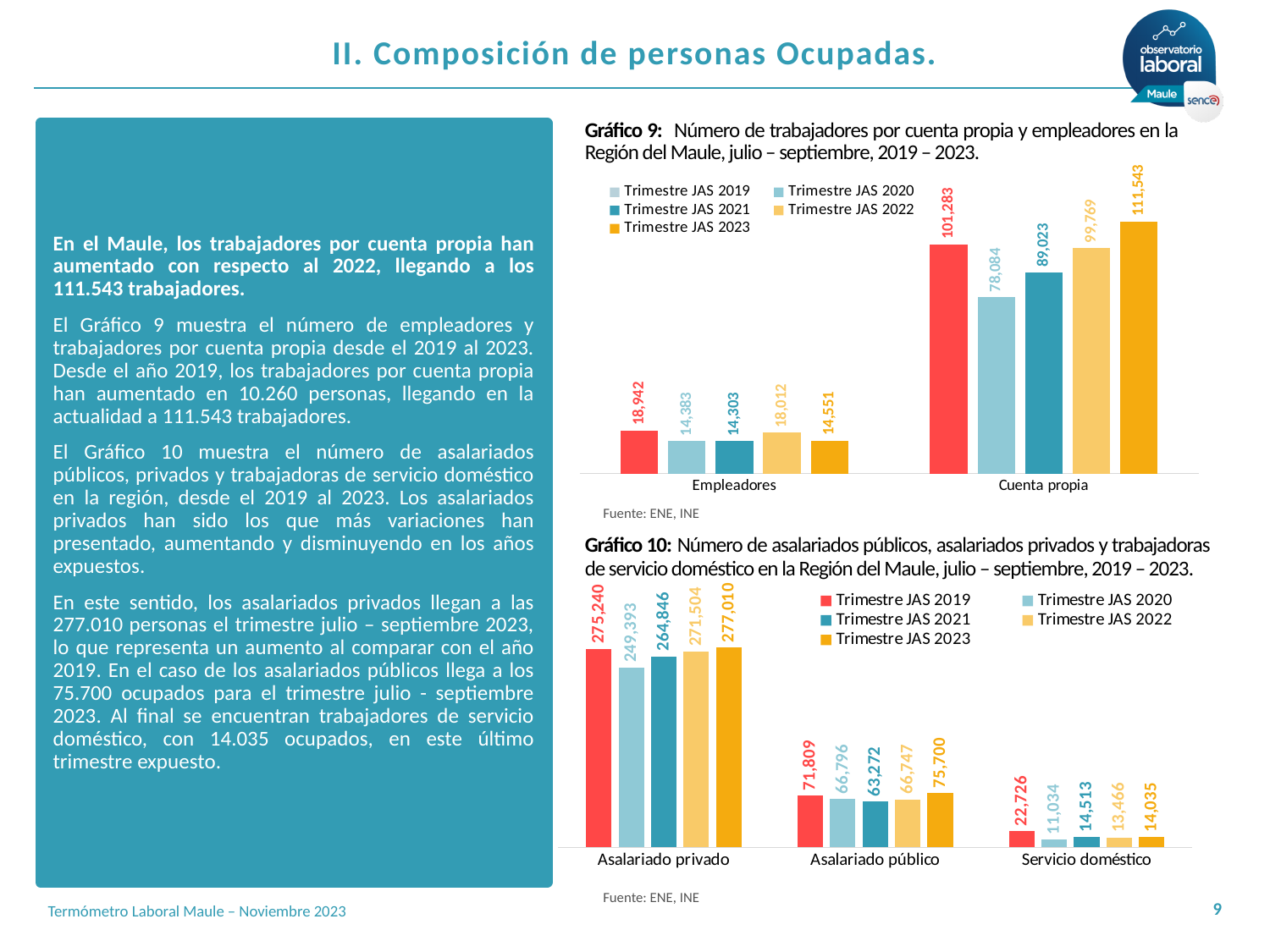
In Gráfico 9, what is the difference between the Cuenta propia values for Trimestre JAS 2023 and Trimestre JAS 2019? 10,260 What kind of chart is Gráfico 9? Bar chart In Gráfico 10, how many categories are shown on the x axis? 3 In Gráfico 10, what is the value for Asalariado privado in Trimestre JAS 2023? 277,010 In Gráfico 10, which trimester has the highest value for Asalariado público? Trimestre JAS 2023 In Gráfico 10, which is larger for Servicio doméstico: Trimestre JAS 2019 or Trimestre JAS 2023? Trimestre JAS 2019 In Gráfico 9, how many series does the legend list? 5 In Gráfico 9, what is the value for Empleadores in Trimestre JAS 2019? 18,942 In Gráfico 10, what is the value for Servicio doméstico in Trimestre JAS 2020? 11,034 In Gráfico 9, what is the value for Cuenta propia in Trimestre JAS 2023? 111,543 In Gráfico 10, what is the difference between the Asalariado público values for Trimestre JAS 2023 and Trimestre JAS 2021? 12,428 In Gráfico 9, which trimester has the lowest value for Cuenta propia? Trimestre JAS 2020